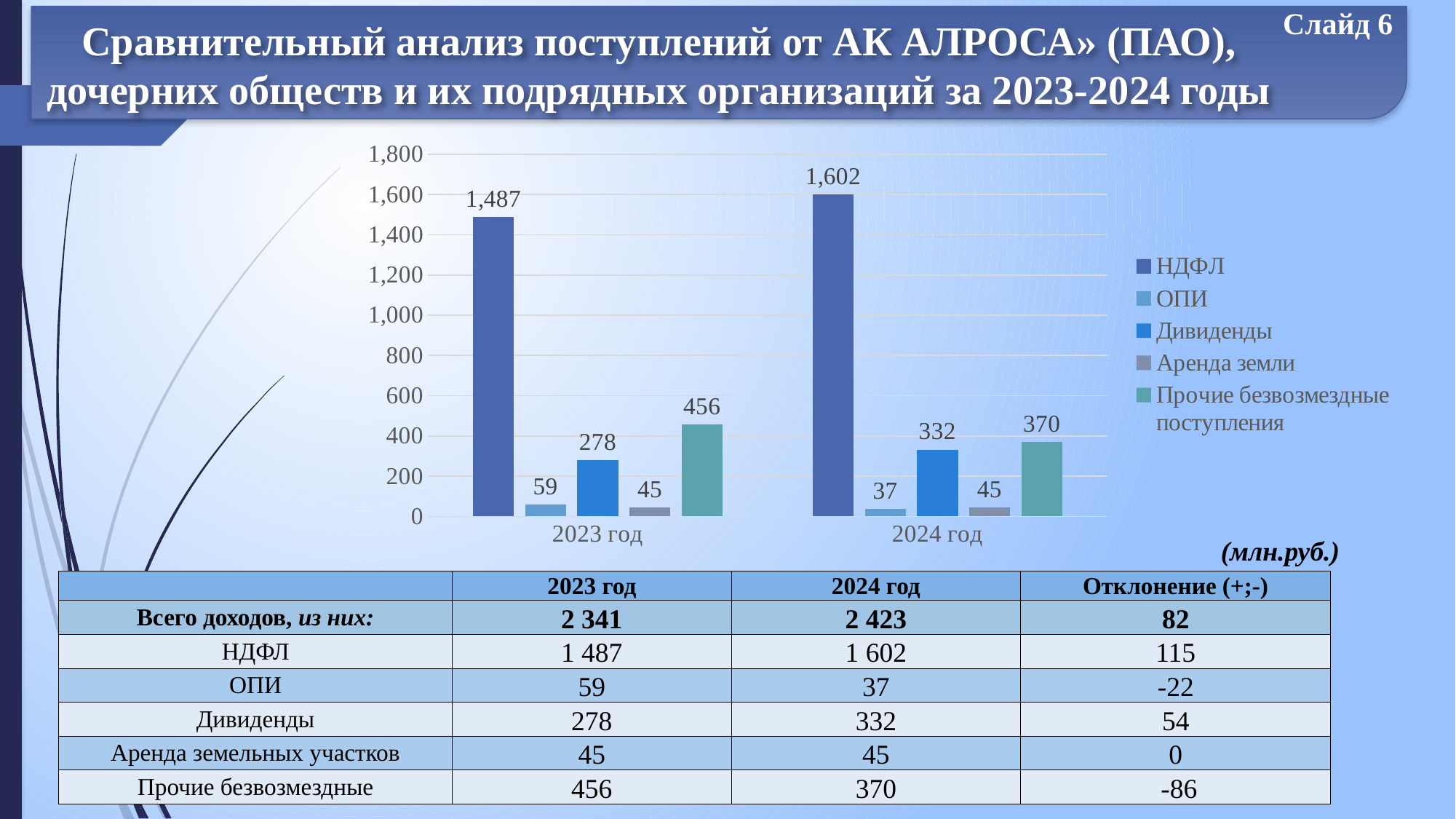
Which series has the lowest value in 2023 год? Аренда земли Does the value of ОПИ rise or fall from 2023 год to 2024 год? Fall How many series does the legend list? 5 Which is larger: Дивиденды in 2023 год or Дивиденды in 2024 год? 2024 год What is the value of ОПИ for 2024 год? 37 Which series has the highest value in 2024 год? НДФЛ What is the difference between Прочие безвозмездные поступления in 2023 год and 2024 год? 86 What is the value of НДФЛ for 2023 год? 1,487 How many categories are shown on the x axis? 2 What is the value of Дивиденды for 2024 год? 332 What kind of chart is shown on the slide? Bar chart What is the difference between the НДФЛ values for 2024 год and 2023 год? 115